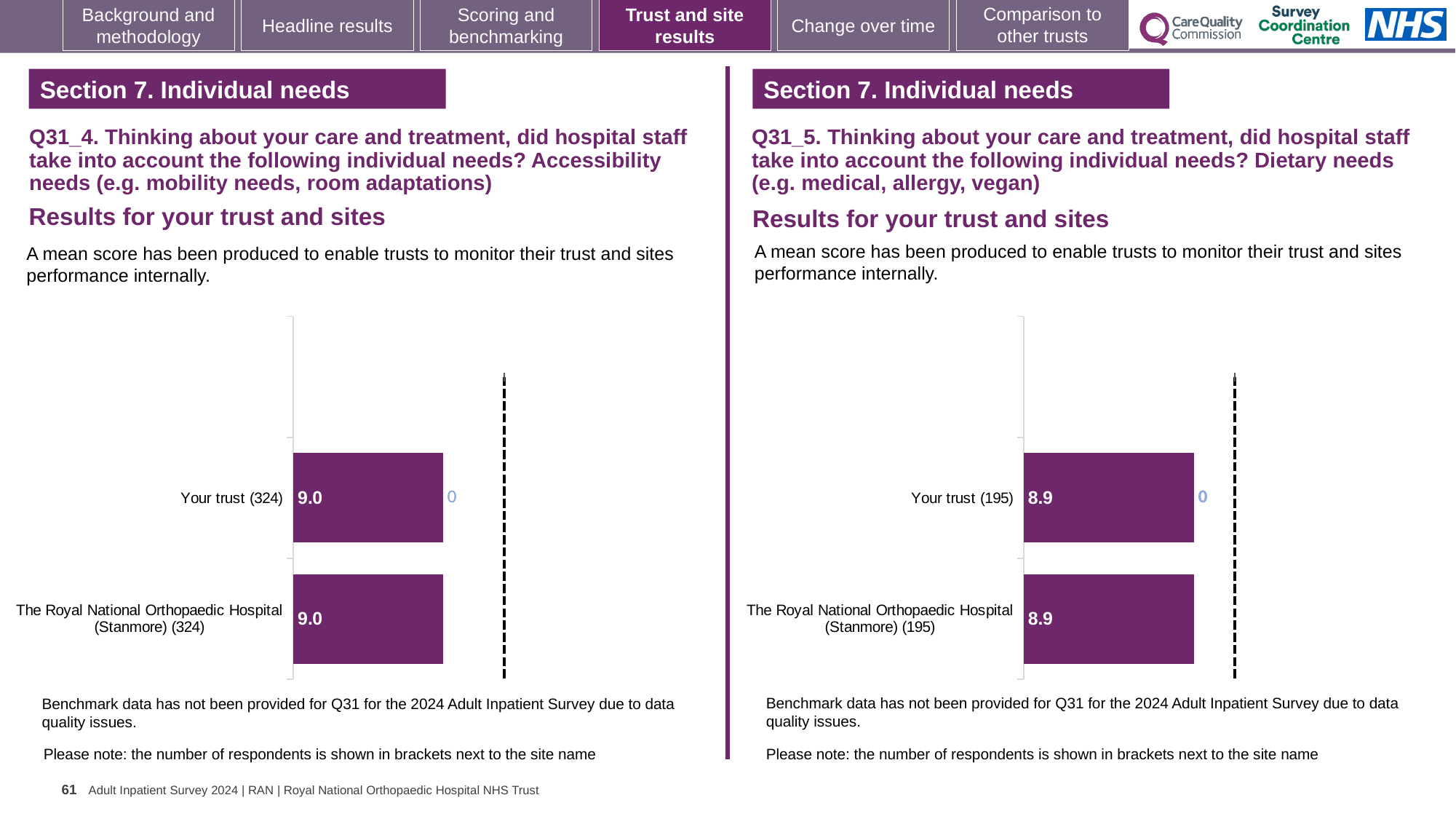
On the right chart (Q31_5, Dietary needs), what is the mean score for The Royal National Orthopaedic Hospital (Stanmore)? 8.9 On the right chart (Q31_5, Dietary needs), how many respondents are shown in brackets next to The Royal National Orthopaedic Hospital (Stanmore)? 195 What type of chart is used on the left side of the slide (Q31_4)? Bar chart On the left chart (Q31_4, Accessibility needs), what is the difference between the score for Your trust and the score for The Royal National Orthopaedic Hospital (Stanmore)? 0.0 How many bars are plotted on the right chart (Q31_5, Dietary needs)? 2 On the left chart (Q31_4, Accessibility needs), what is the mean score for The Royal National Orthopaedic Hospital (Stanmore)? 9.0 What type of chart is used on the right side of the slide (Q31_5)? Bar chart On the left chart (Q31_4, Accessibility needs), how many respondents are shown in brackets next to Your trust? 324 On the right chart (Q31_5, Dietary needs), what is the difference between the score for Your trust and the score for The Royal National Orthopaedic Hospital (Stanmore)? 0.0 On the left chart (Q31_4, Accessibility needs), what is the mean score for Your trust? 9.0 How many bars are plotted on the left chart (Q31_4, Accessibility needs)? 2 On the right chart (Q31_5, Dietary needs), what is the mean score for Your trust? 8.9